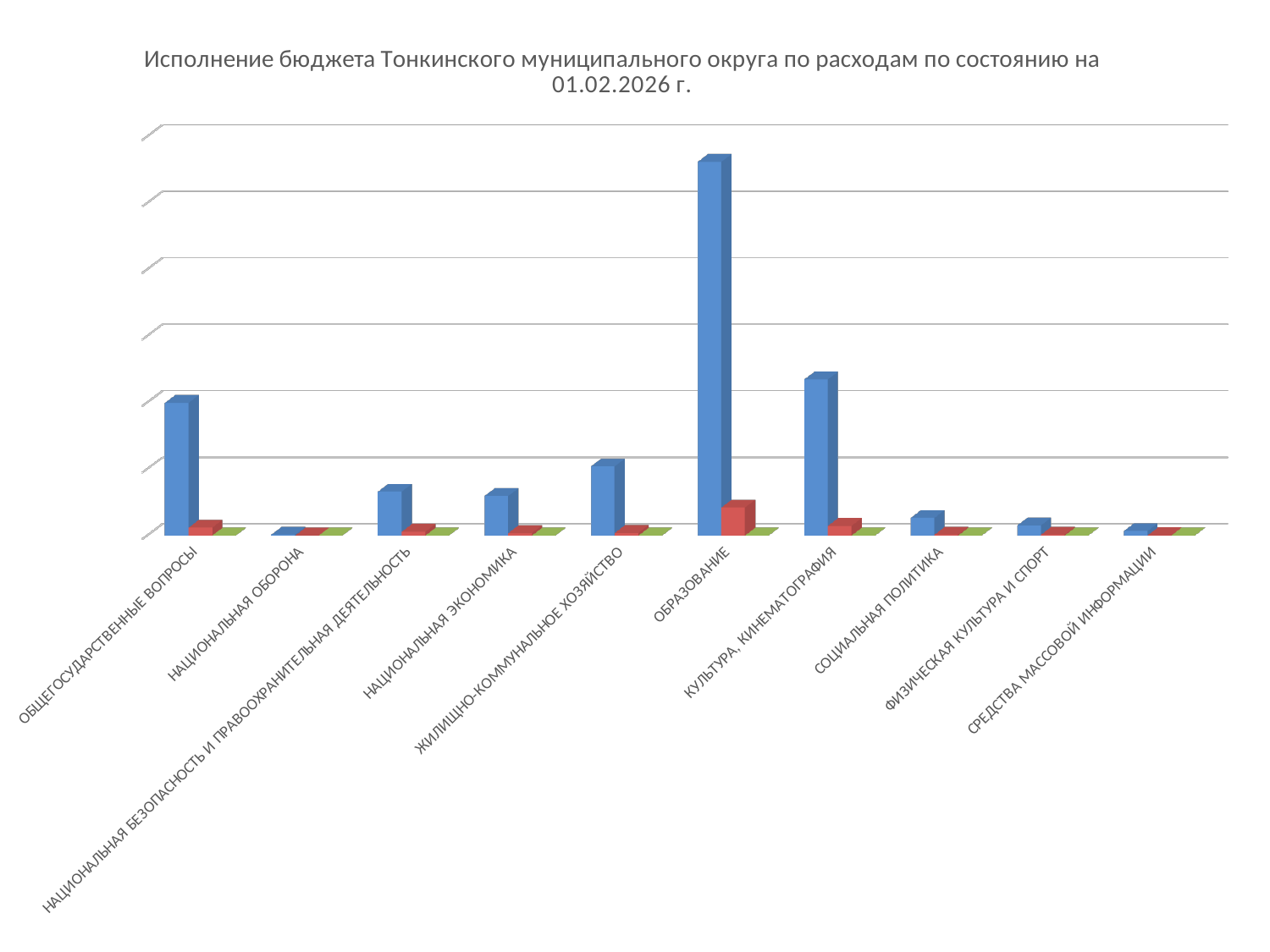
Which has the taller blue bar: ОБЩЕГОСУДАРСТВЕННЫЕ ВОПРОСЫ or КУЛЬТУРА, КИНЕМАТОГРАФИЯ? КУЛЬТУРА, КИНЕМАТОГРАФИЯ What kind of chart is shown on the slide? Bar chart Which has the taller blue bar: ЖИЛИЩНО-КОММУНАЛЬНОЕ ХОЗЯЙСТВО or НАЦИОНАЛЬНАЯ ЭКОНОМИКА? ЖИЛИЩНО-КОММУНАЛЬНОЕ ХОЗЯЙСТВО What is the title of the chart? Исполнение бюджета Тонкинского муниципального округа по расходам по состоянию на 01.02.2026 г. Which has the taller blue bar: СОЦИАЛЬНАЯ ПОЛИТИКА or ФИЗИЧЕСКАЯ КУЛЬТУРА И СПОРТ? СОЦИАЛЬНАЯ ПОЛИТИКА How many categories are shown along the x axis of the chart? 10 Which category has the second tallest blue bar in the chart? КУЛЬТУРА, КИНЕМАТОГРАФИЯ Which category has the tallest red bar in the chart? ОБРАЗОВАНИЕ Which category has the tallest blue bar in the chart? ОБРАЗОВАНИЕ How many differently coloured series of bars are plotted for each category? 3